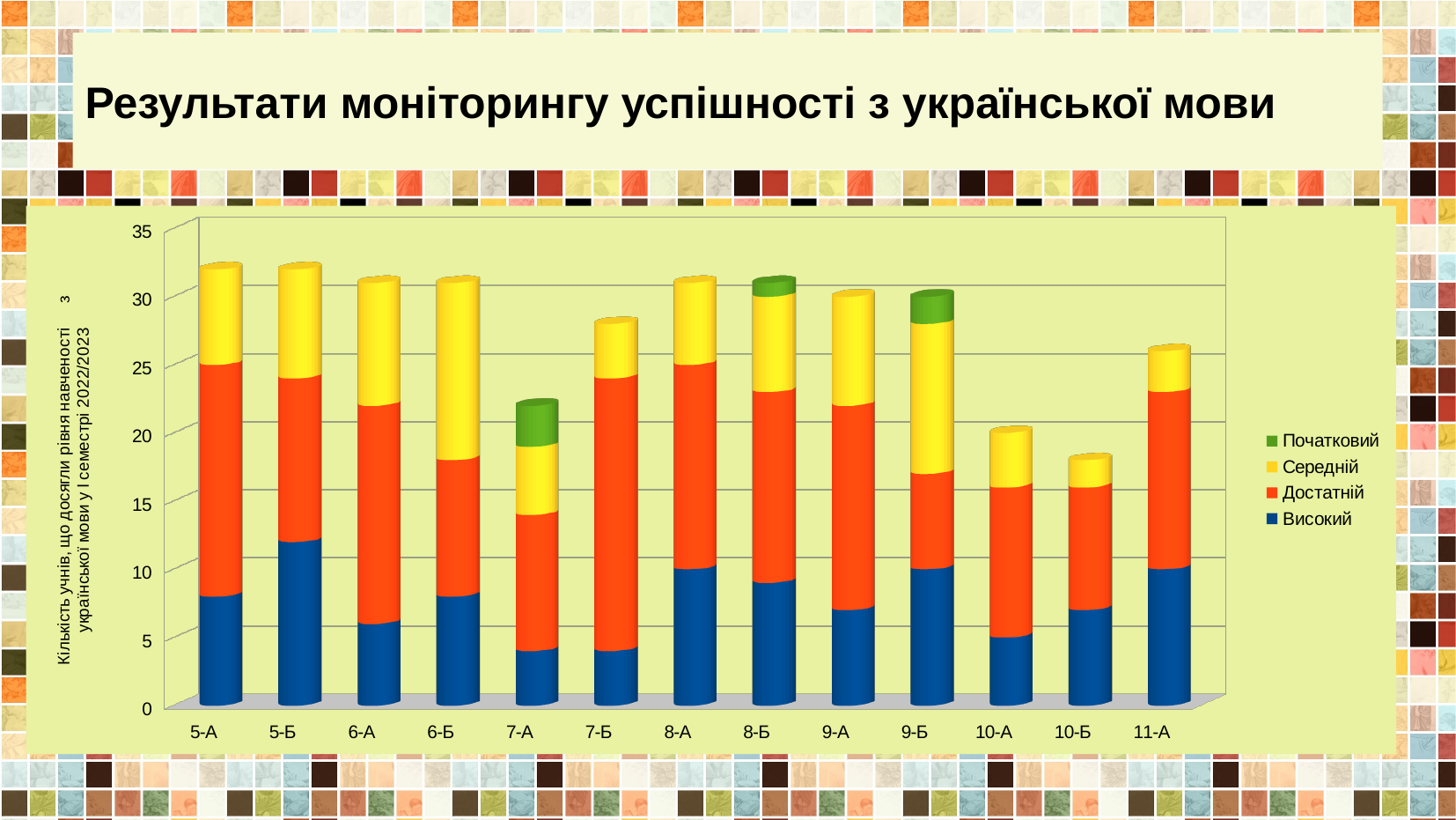
Is the total height of the bar for 10-Б greater or less than 20? less Is the total height of the bar for 7-А greater or less than 25? less Is the total height of the bar for 5-А greater or less than 30? greater How many classes (categories) are shown on the x axis? 13 Which series forms the bottom segment of each stacked bar? Високий Which series is shown in green in the legend? Початковий Which class has the taller total bar, 7-А or 7-Б? 7-Б What kind of chart is shown on the slide? Stacked bar chart Which class has the larger Високий segment, 5-А or 5-Б? 5-Б How many series does the legend list? 4